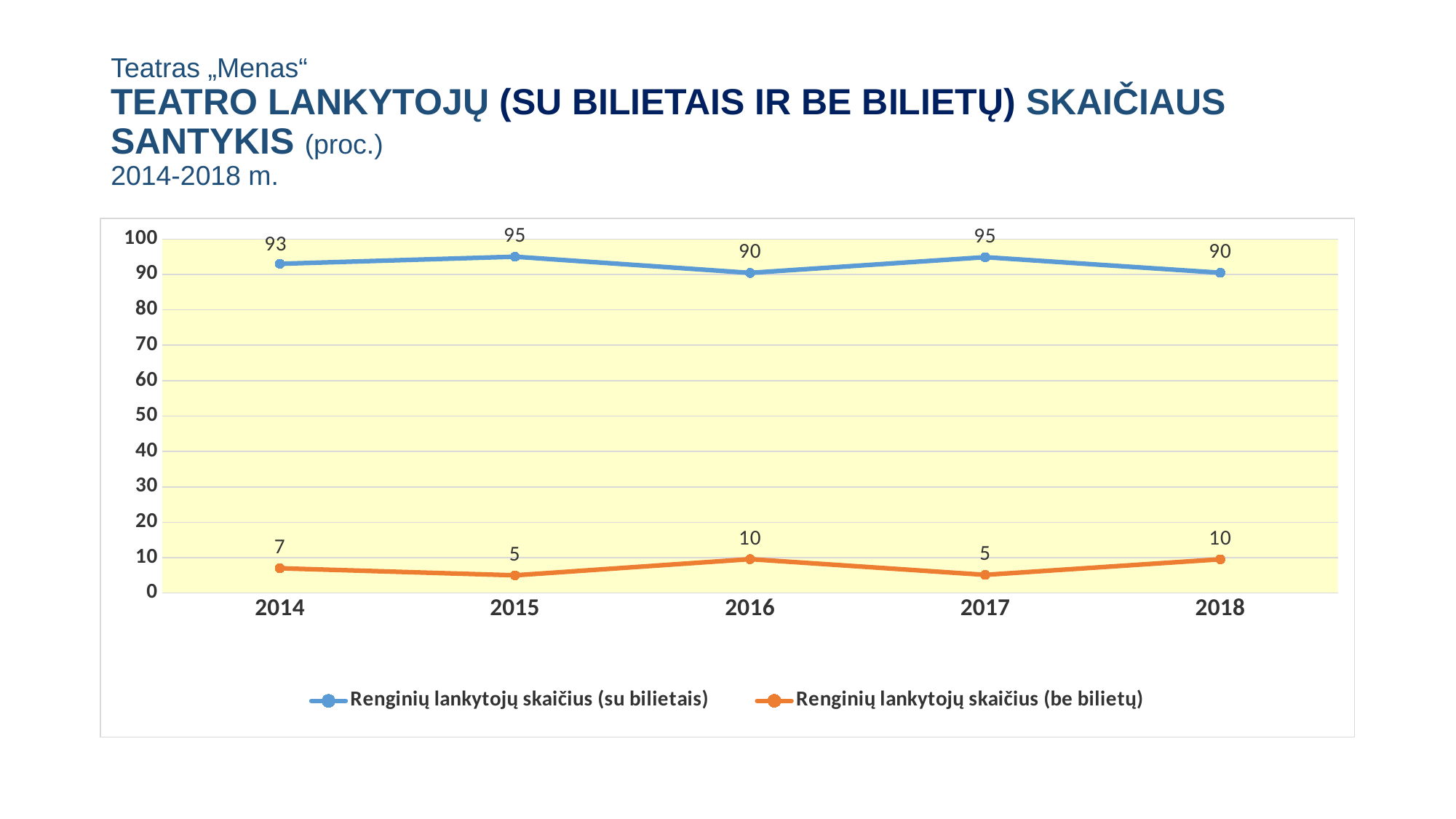
Which is larger: the "be bilietų" value in 2016 or in 2017? 2016 What is the value for "Renginių lankytojų skaičius (su bilietais)" in 2014? 93 In which year is the value for "Renginių lankytojų skaičius (be bilietų)" lowest, 2015 or 2017 (both show the same value)? Give the value. 5 What is the value for "Renginių lankytojų skaičius (su bilietais)" in 2018? 90 How many series does the legend list? 2 How many years are shown on the x axis? 5 What is the value for "Renginių lankytojų skaičius (be bilietų)" in 2016? 10 What kind of chart is shown on the slide? line chart What is the difference between the "su bilietais" and "be bilietų" values in 2014? 86 What is the difference between the "su bilietais" values in 2015 and 2016? 5 What is the value for "Renginių lankytojų skaičius (be bilietų)" in 2017? 5 Is the value for "Renginių lankytojų skaičius (su bilietais)" in 2016 greater or less than 80? greater